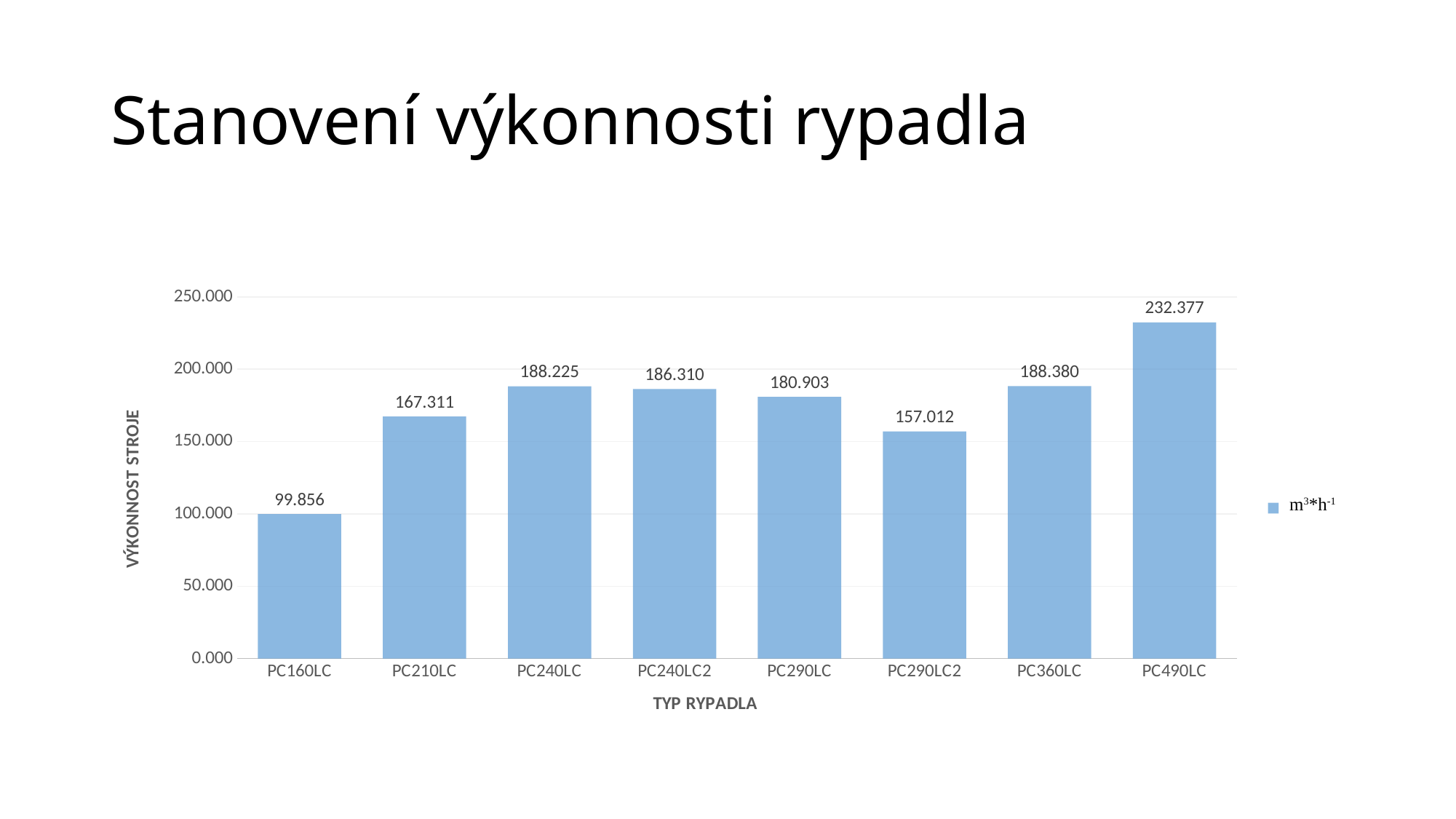
What kind of chart is shown on the slide? bar chart What is the difference between the values for PC290LC and PC290LC2? 23.891 What is the difference between the values for PC490LC and PC160LC? 132.521 Which excavator type has the highest value? PC490LC Is the value for PC490LC greater or less than 200.000? greater What is the value for PC360LC? 188.380 What is the title of the x axis? TYP RYPADLA Which has a larger value, PC210LC or PC290LC? PC290LC What is the value for PC290LC2? 157.012 Which excavator type has the lowest value? PC160LC How many excavator types are shown on the x axis? 8 What is the value for PC160LC? 99.856